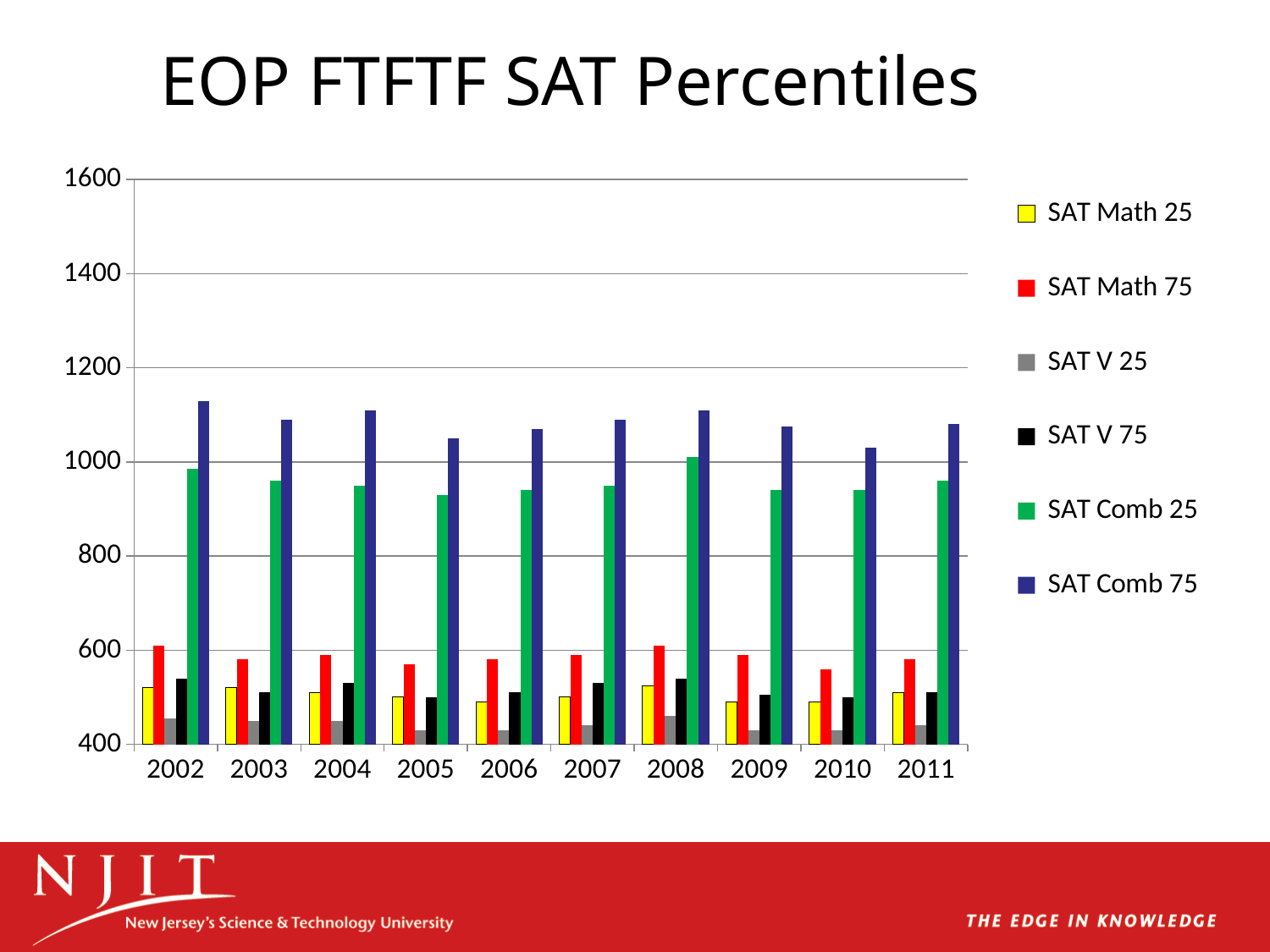
In which year is SAT Comb 25 highest? 2008 Which is larger, SAT Comb 75 in 2002 or SAT Comb 75 in 2010? 2002 In 2002, which is larger, SAT Math 75 or SAT V 75? SAT Math 75 How many series does the chart's legend list? 6 How many years are shown on the x axis of the chart? 10 Is the value for SAT Comb 75 in 2002 greater or less than 1000? greater Is the value for SAT Math 25 in 2004 greater or less than 600? less What kind of chart is shown on the slide? bar chart Is the value for SAT V 25 in 2002 greater or less than 600? less Which series is plotted in blue? SAT Comb 75 What is the title of the chart? EOP FTFTF SAT Percentiles